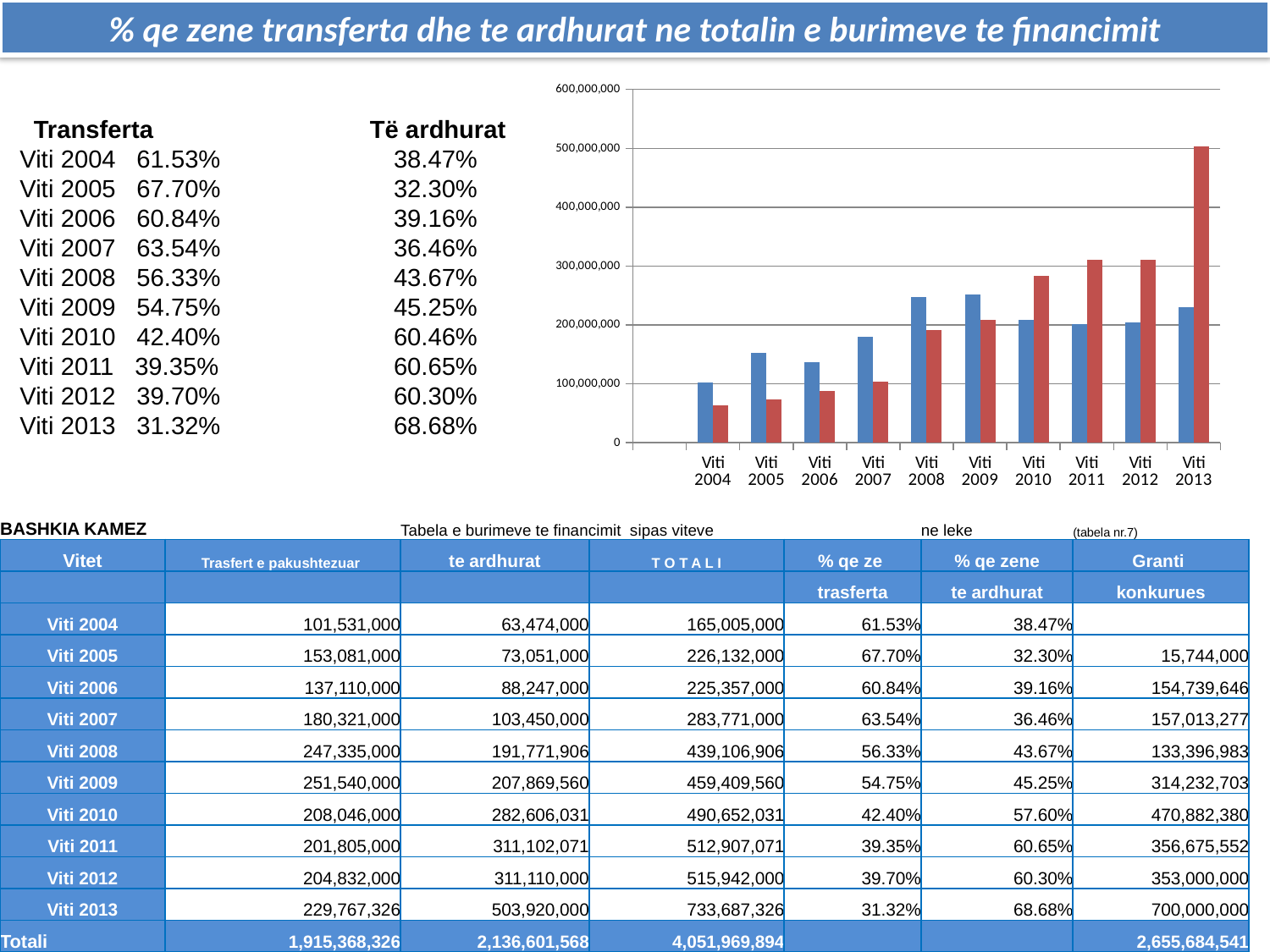
What is the highest value shown on the chart's vertical axis? 600,000,000 Is the blue bar for Viti 2004 greater or less than 200,000,000? less How many years (categories) are shown on the x axis of the chart? 10 For which year is the red bar the shortest? Viti 2004 For which year is the blue bar the shortest? Viti 2004 For which year is the red bar the tallest? Viti 2013 How many bars are plotted for each year in the chart? 2 Is the red bar for Viti 2013 greater or less than 400,000,000? greater Is the blue bar for Viti 2008 greater or less than 300,000,000? less What kind of chart is shown on the slide? bar chart For Viti 2004, which bar is taller, the blue one or the red one? the blue one